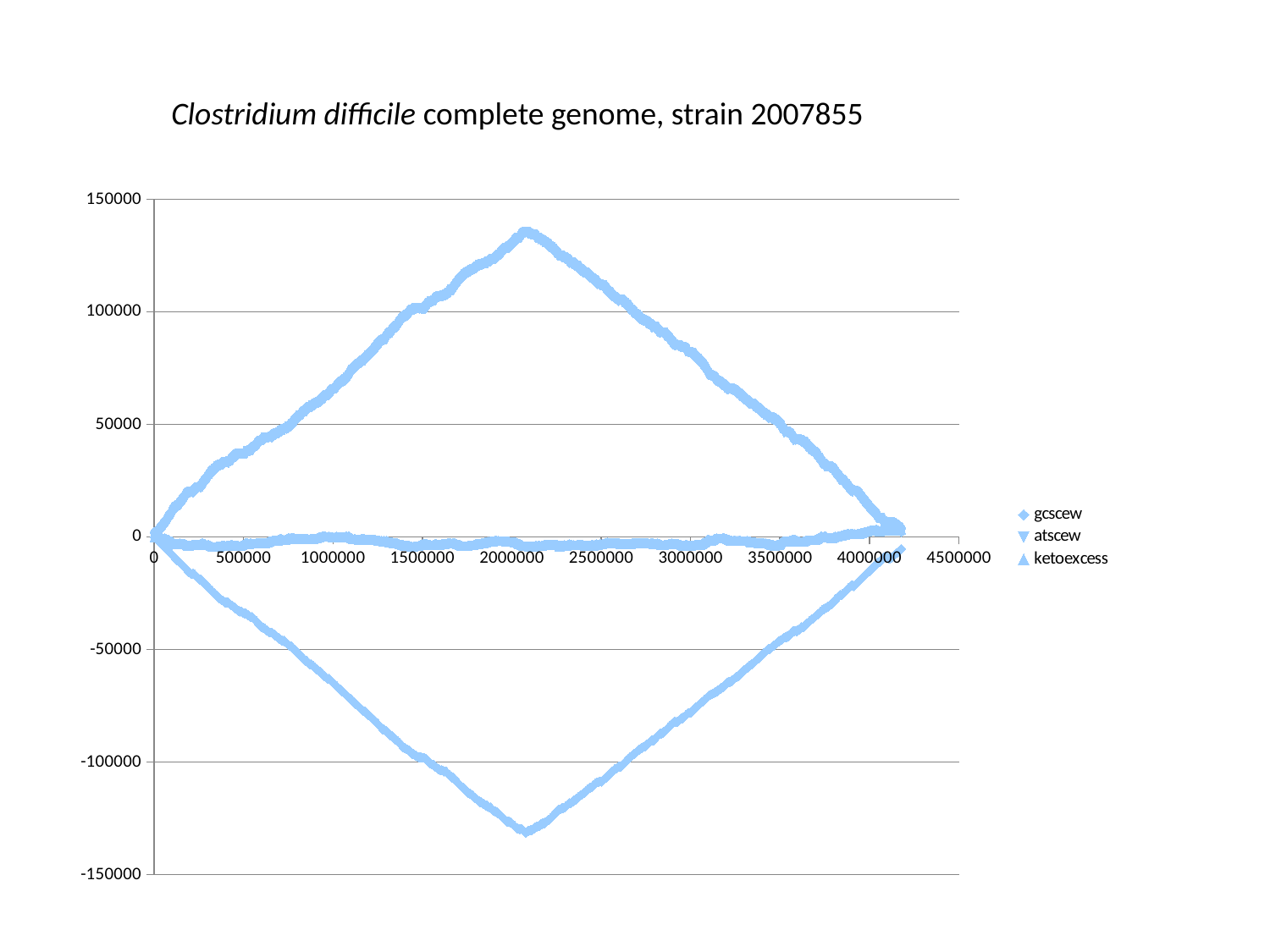
How many series does the legend list? 3 Does the upper curve rise or fall as x increases from 2000000 to 4000000? fall Is the value of the upper curve at x = 500000 greater or less than 50000? less What is the title of the chart? Clostridium difficile complete genome, strain 2007855 What are the names of the series listed in the legend? gcscew, atscew, ketoexcess Is the lowest value of the lower curve greater or less than -100000? less Is the value of the upper curve at x = 1000000 greater or less than 50000? greater Does the upper curve rise or fall as x increases from 0 to 2000000? rise What is the highest value shown on the y axis? 150000 What kind of chart is shown on the slide? scatter chart